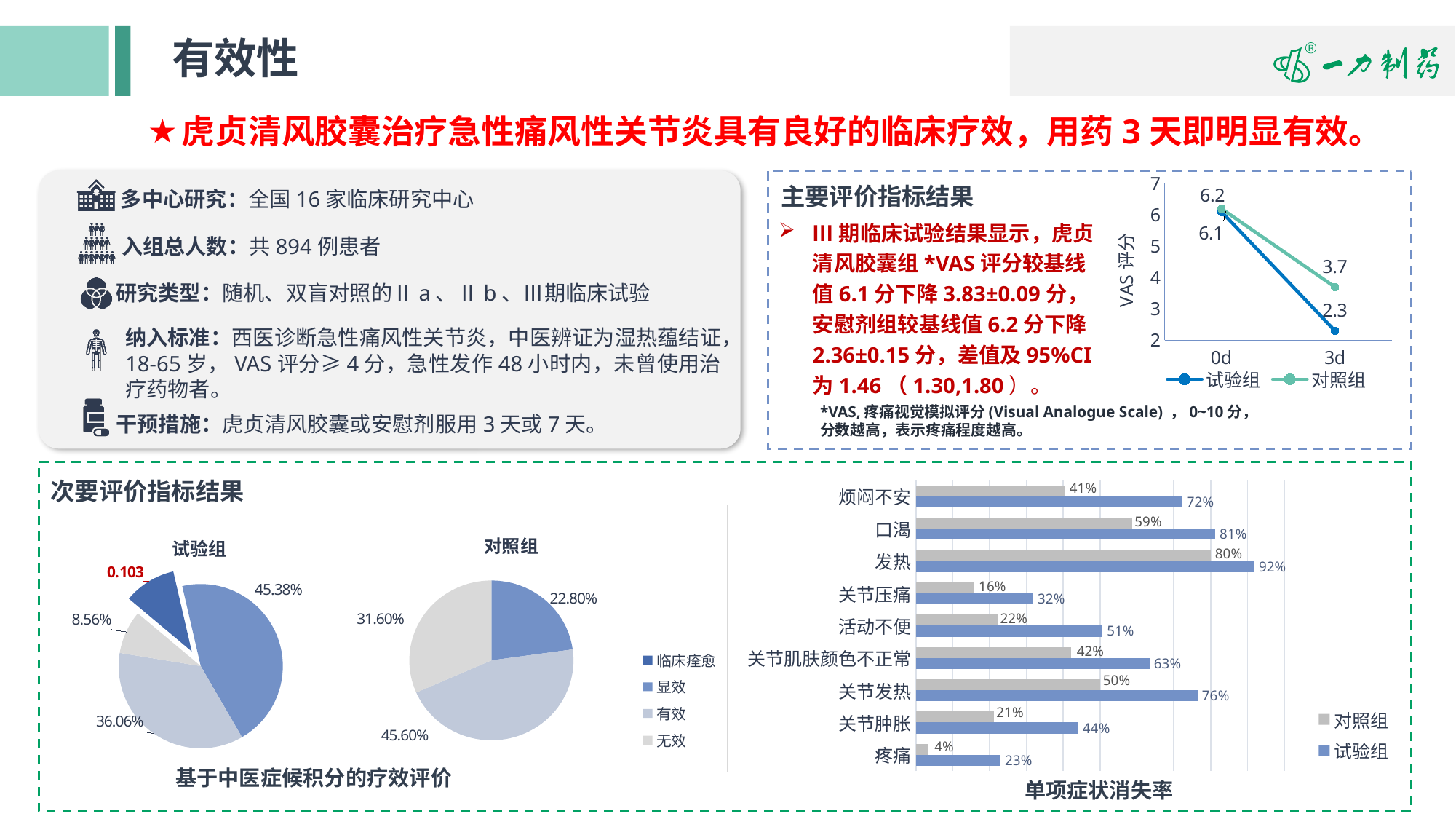
In the VAS评分 line chart, what is the value for 对照组 at 0d? 6.2 What kind of chart is the 单项症状消失率 chart? Bar chart In the 单项症状消失率 bar chart, which symptom has the lowest 试验组 value? 疼痛 In the VAS评分 line chart, how many series does the legend list? 2 In the 单项症状消失率 bar chart, what is the difference between the 试验组 and 对照组 values for 活动不便? 29% In the VAS评分 line chart, what is the value for 试验组 at 3d? 2.3 In the 单项症状消失率 bar chart, what is the value for 试验组 for 发热? 92% In the 单项症状消失率 bar chart, how many symptom categories are shown? 9 In the 试验组 pie chart, which category has the largest share? 显效 In the 对照组 pie chart, what share does 有效 have? 45.60% In the 单项症状消失率 bar chart, what is the value for 对照组 for 疼痛? 4% In the VAS评分 line chart, by how much does the 对照组 value fall from 0d to 3d? 2.5